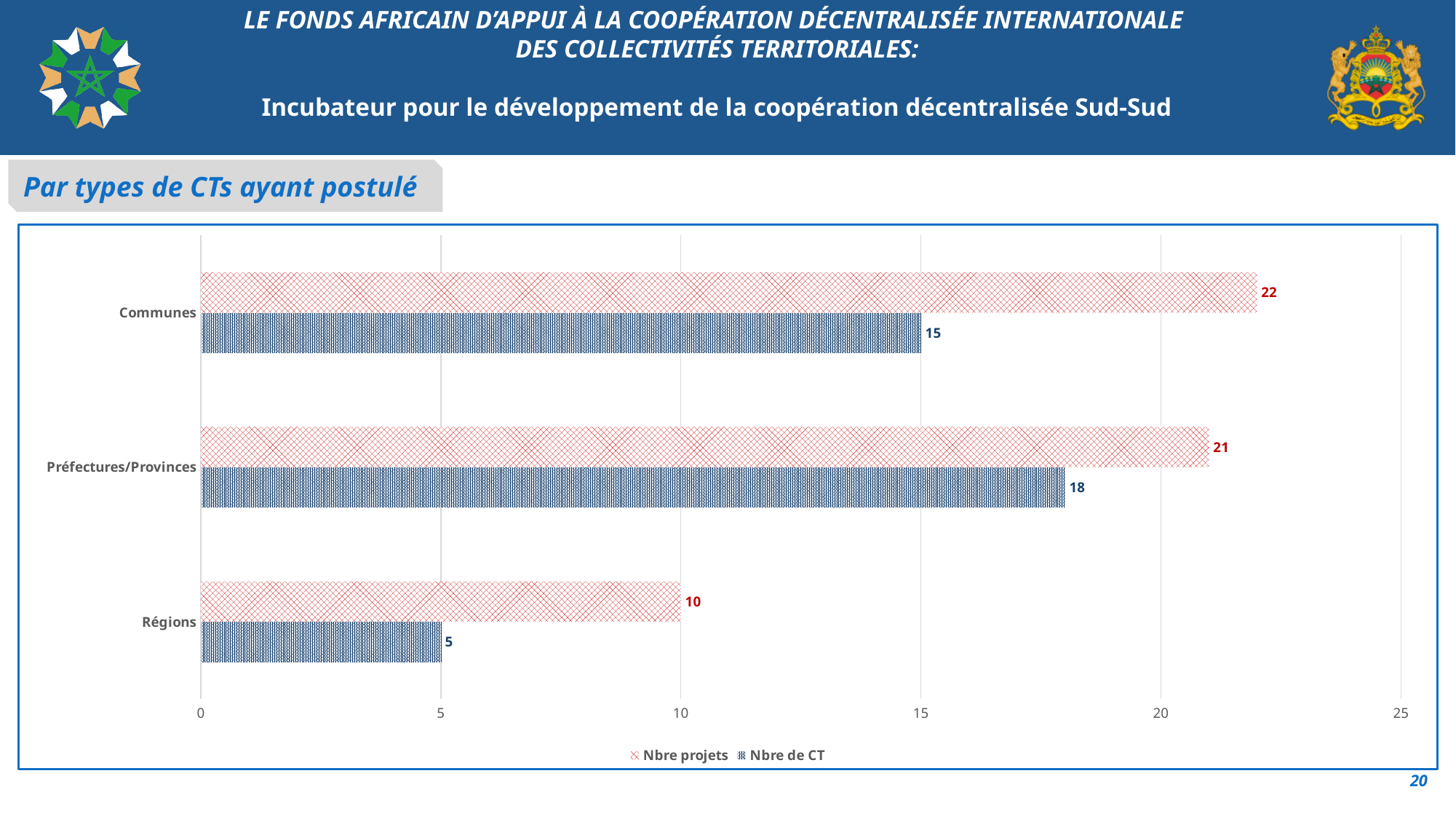
How many series does the legend list? 2 What is the value of Nbre de CT for Régions? 5 What is the value of Nbre de CT for Préfectures/Provinces? 18 What is the value of Nbre projets for Communes? 22 Is the Nbre projets value for Préfectures/Provinces greater or less than 20? greater Which is larger for Régions: Nbre projets or Nbre de CT? Nbre projets How many categories are shown on the chart? 3 Which category has the lowest Nbre de CT value? Régions What kind of chart is shown on the slide? Bar chart Which category has the highest Nbre projets value? Communes What is the difference between Nbre projets and Nbre de CT for Communes? 7 What is the title shown above the chart? Par types de CTs ayant postulé